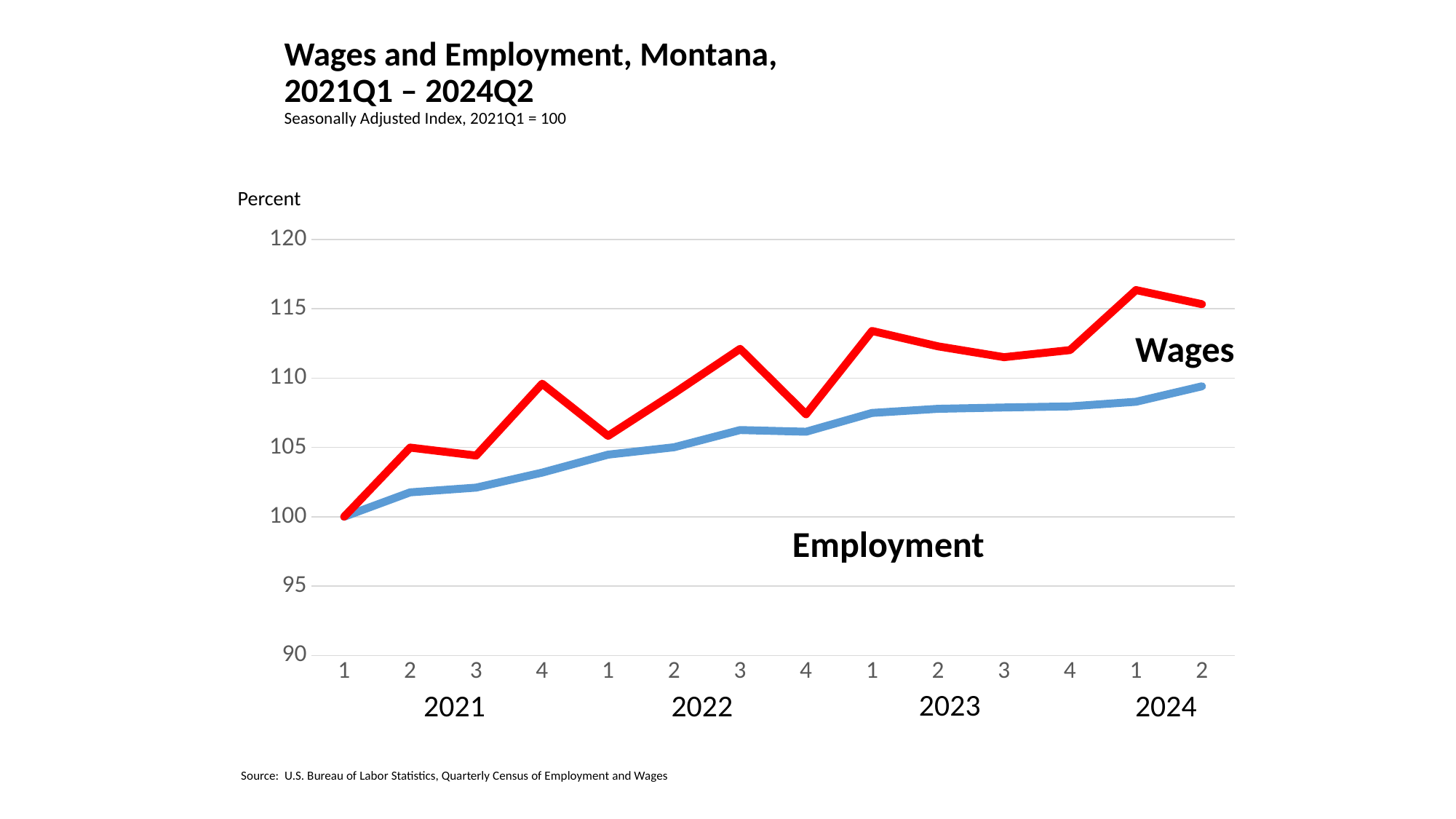
Is the value for Wages in 2024 quarter 1 greater or less than 115? greater How many quarterly data points does each line have? 14 Does the Employment line generally rise or fall from 2021 quarter 1 to 2024 quarter 2? rise In which quarter does the Employment line reach its highest value? 2024 quarter 2 Is the value for Wages in 2022 quarter 4 greater or less than 105? greater In which quarter is the Employment index at its lowest? 2021 quarter 1 Is the value for Employment in 2024 quarter 2 greater or less than 110? less What is the index value for Wages in 2021 quarter 1? 100 In which quarter does the Wages line reach its highest value? 2024 quarter 1 What kind of chart is shown on the slide? line chart In 2022 quarter 3, which series has the higher value, Wages or Employment? Wages How many series are plotted on the chart? 2